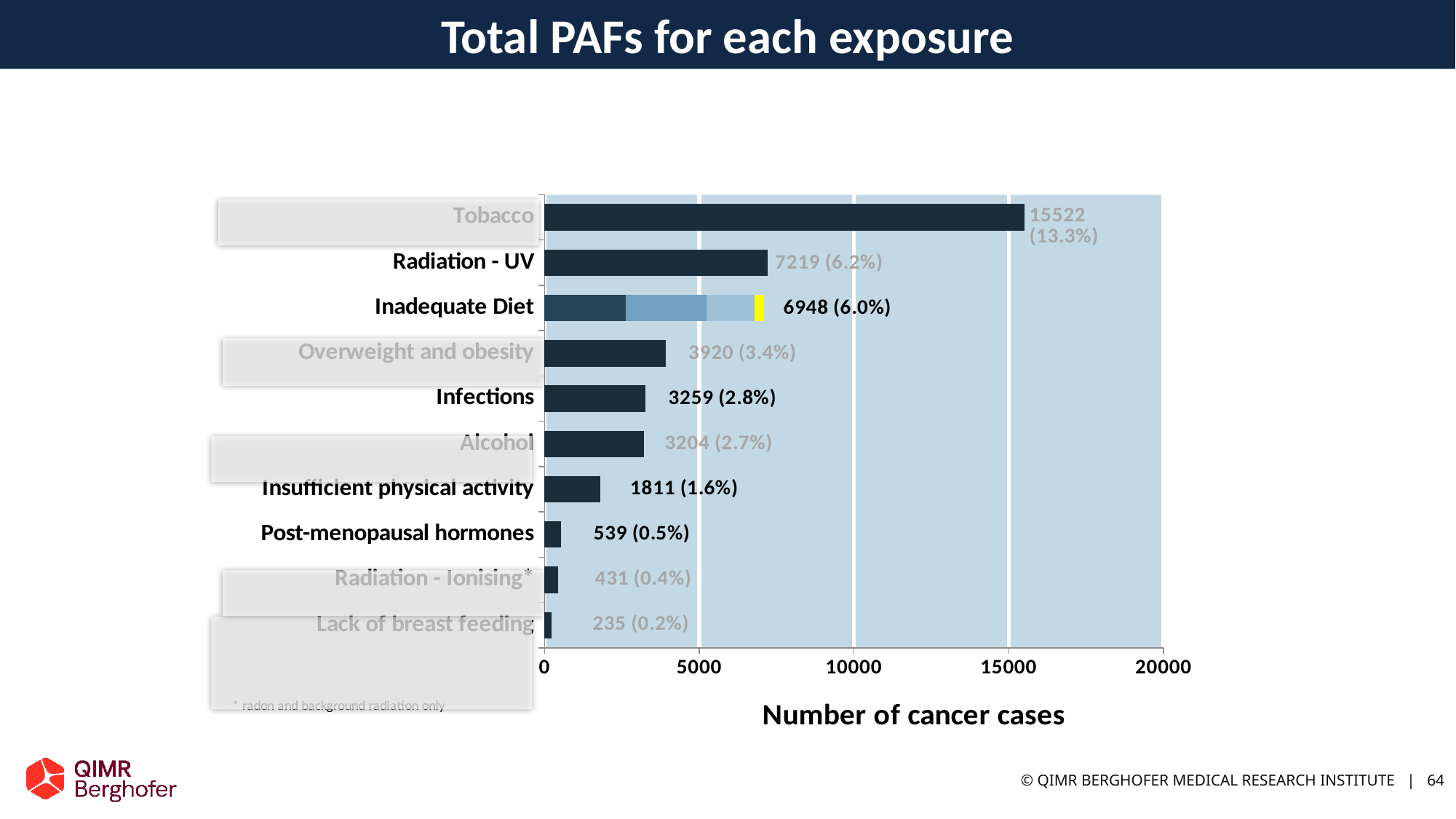
Which has more cancer cases, Radiation - UV or Inadequate Diet? Radiation - UV Is the value for Overweight and obesity greater or less than 5000? less Which exposure has the lowest number of cancer cases? Lack of breast feeding How many cancer cases are attributed to Tobacco? 15522 Which exposure has the highest number of cancer cases? Tobacco What is the difference in cancer cases between Infections and Alcohol? 55 What is the difference in cancer cases between Tobacco and Radiation - UV? 8303 What is the number of cancer cases shown for Infections? 3259 What is the label of the horizontal axis? Number of cancer cases What percentage is shown next to the Inadequate Diet bar? 6.0% What kind of chart is shown on the slide? bar chart How many exposure categories are shown in the chart? 10